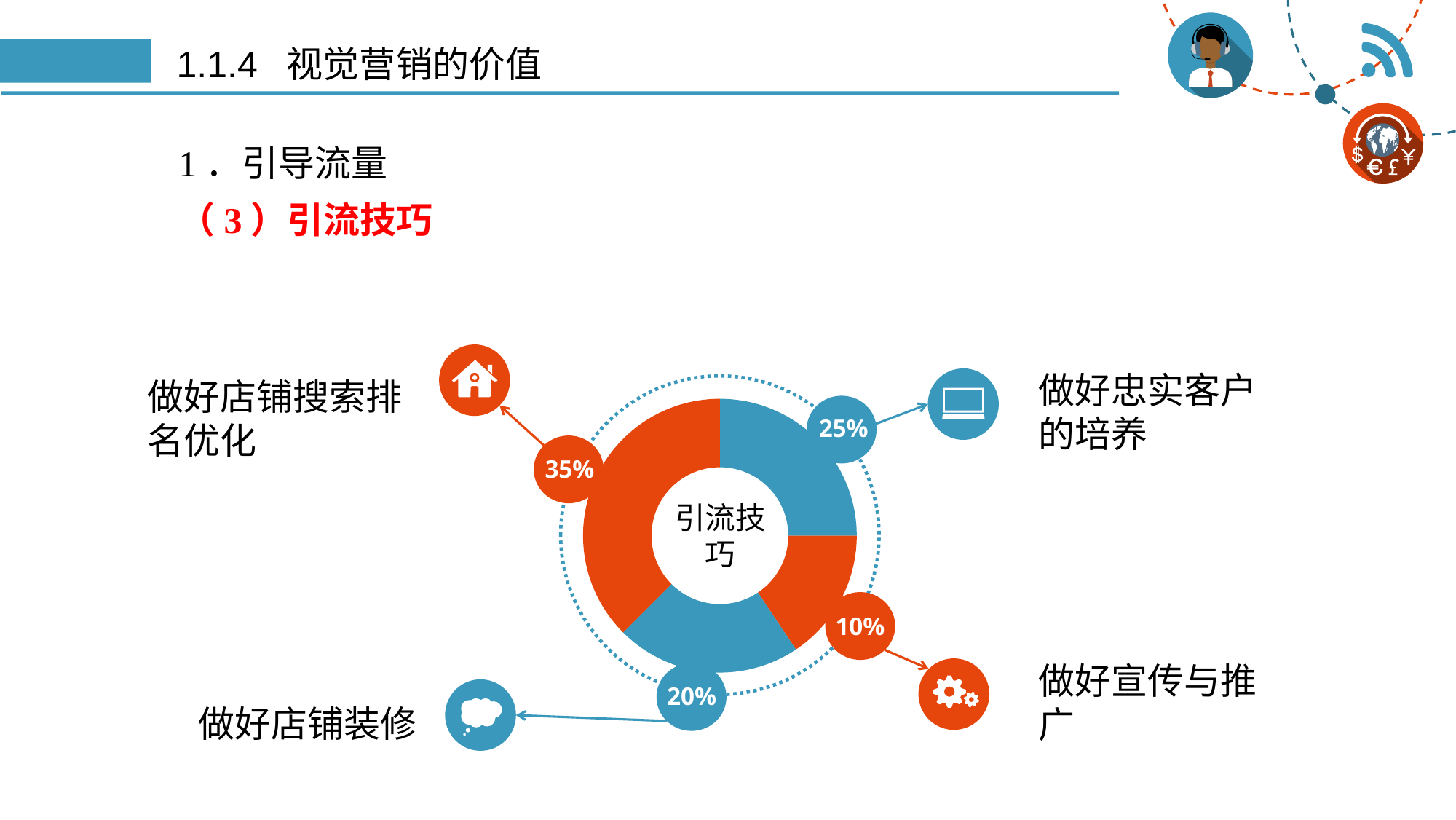
What is the title shown in the centre of the donut chart? 引流技巧 What colour is the segment labelled 10%? Orange Which category has the largest share in the donut chart? 做好店铺搜索排名优化 Which is larger, the share for 做好忠实客户的培养 or the share for 做好店铺装修? 做好忠实客户的培养 What percentage is shown for 做好宣传与推广? 10% What percentage is shown for 做好店铺装修? 20% What percentage is shown for 做好店铺搜索排名优化? 35% What kind of chart is shown on the slide? Donut (pie) chart What is the difference between the shares for 做好店铺搜索排名优化 and 做好店铺装修? 15% How many segments does the donut chart have? 4 What percentage is shown for 做好忠实客户的培养? 25% Which category has the smallest share in the donut chart? 做好宣传与推广